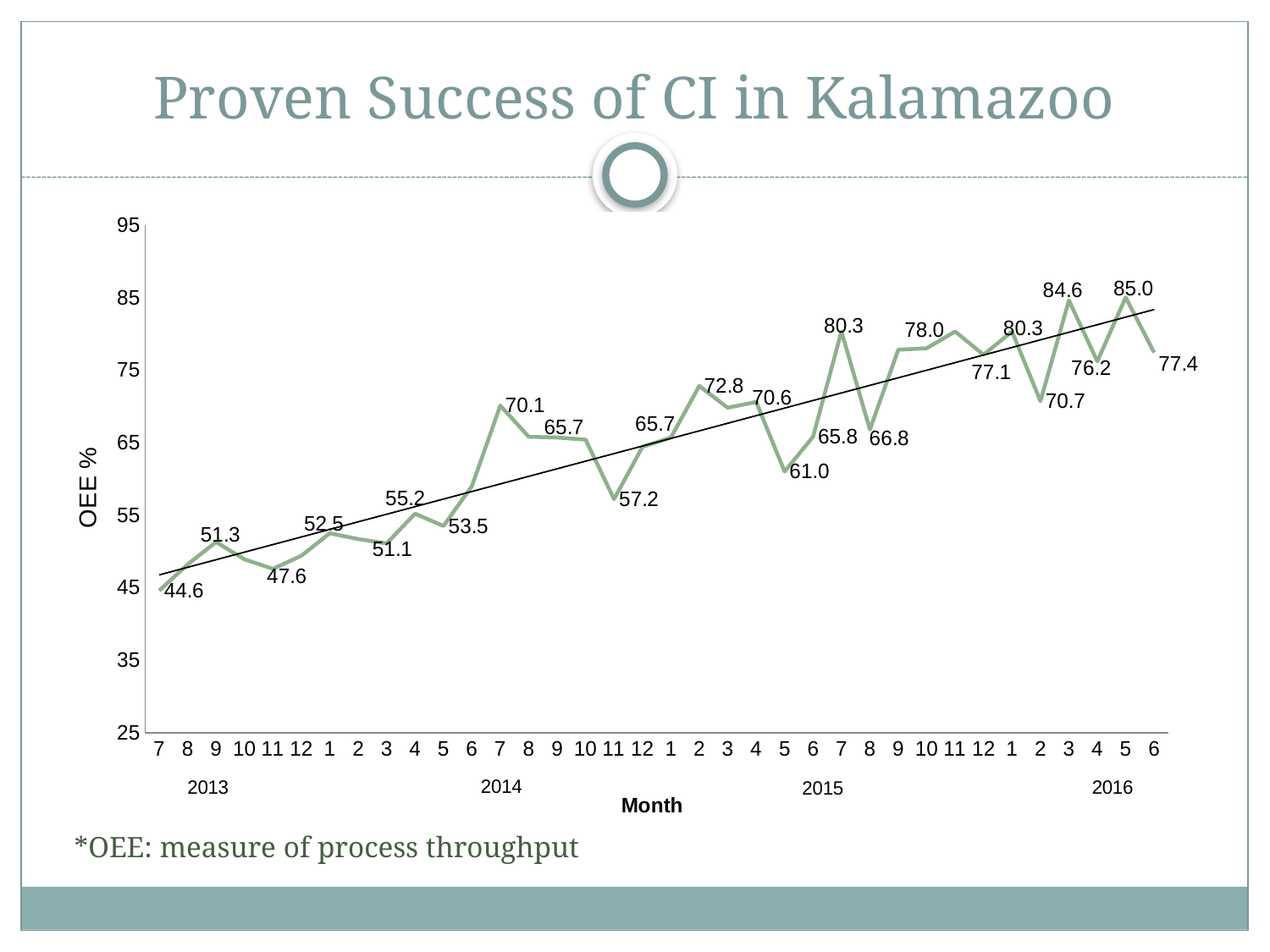
What kind of chart is shown on the slide? line chart What is the difference between the highest labelled value (85.0) and the lowest labelled value (44.6)? 40.4 What is the OEE % value for month 6 of 2016, the last point on the chart? 77.4 What is the highest OEE % value labelled on the chart? 85.0 Overall, does the OEE % rise or fall from 2013 to 2016 along the x axis? rise Is the OEE % value for month 7 of 2013 greater or less than 55? less What is the OEE % value for month 7 of 2013, the first point on the chart? 44.6 What is the OEE % value at the peak in month 7 of 2015? 80.3 Which is larger: the OEE % at month 3 of 2016 (84.6) or at month 5 of 2016 (85.0)? 85.0 at month 5 of 2016 What is the lowest OEE % value labelled on the chart? 44.6 What is the label on the vertical axis of the chart? OEE % What is the title of the chart on the slide? Proven Success of CI in Kalamazoo